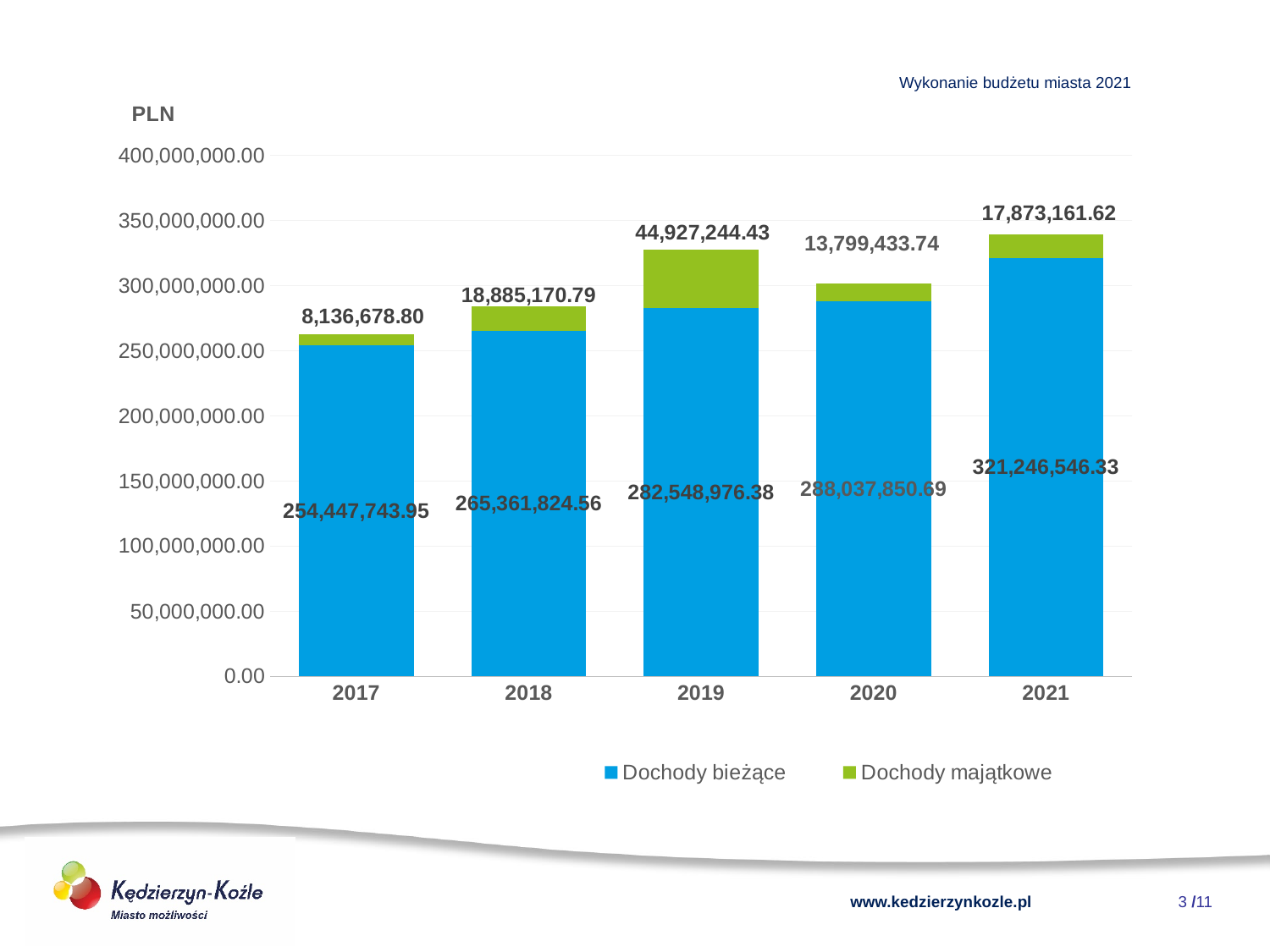
What is the total of the stacked bar for 2017? 262,584,422.75 What is the difference between Dochody bieżące in 2021 and in 2020? 33,208,695.64 Does Dochody bieżące rise or fall from 2017 to 2021? Rise How many years are shown on the x axis? 5 What is the value of Dochody majątkowe for 2021? 17,873,161.62 What is the value of Dochody majątkowe for 2017? 8,136,678.80 In which year is Dochody majątkowe highest? 2019 How many series does the legend list? 2 Which colour represents Dochody majątkowe in the chart? Green In which year is Dochody bieżące lowest? 2017 What is the value of Dochody bieżące for 2019? 282,548,976.38 What kind of chart is shown on the slide? Stacked bar chart